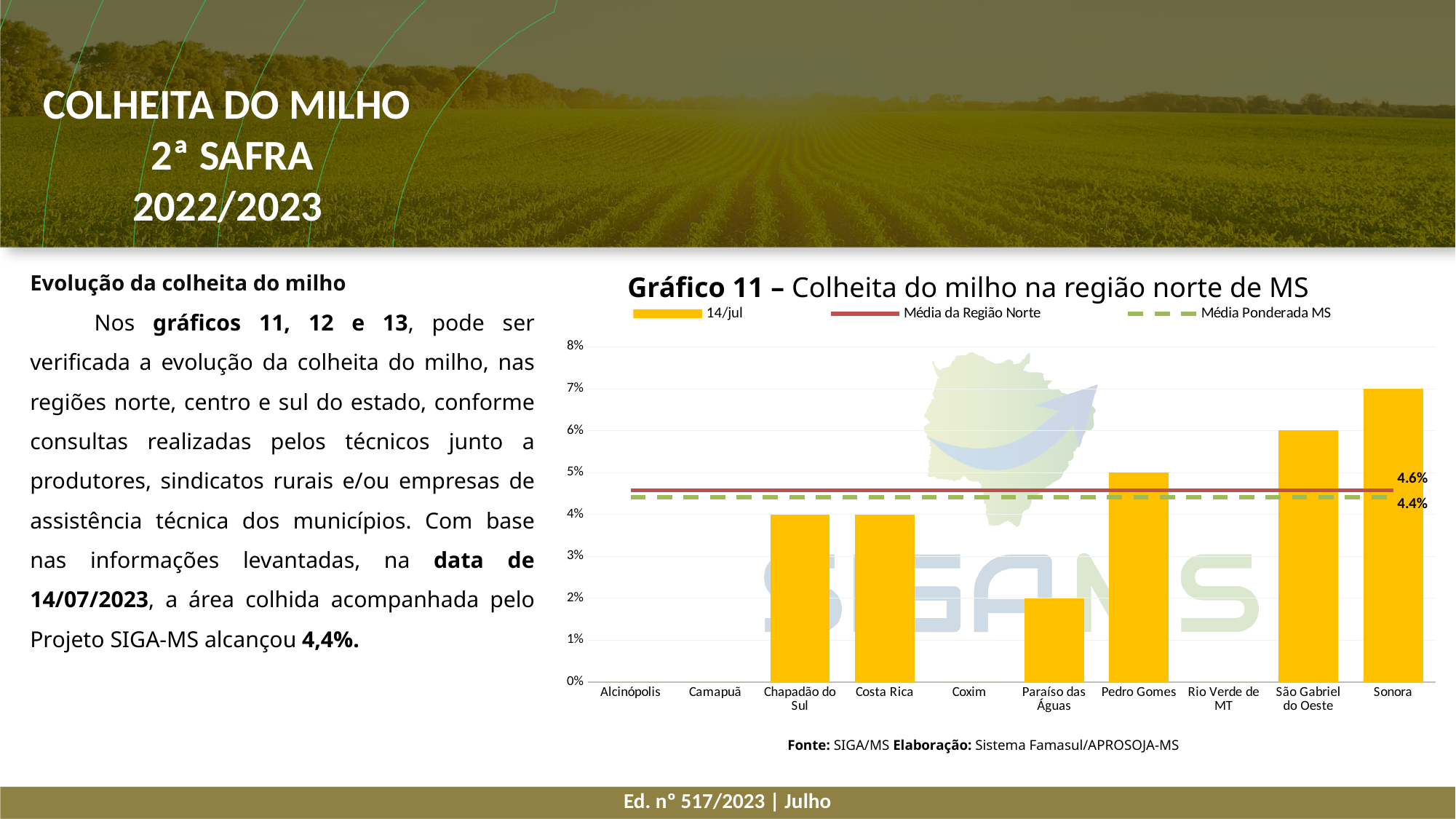
What type of chart is Gráfico 11? bar chart What value is labelled for Média da Região Norte in Gráfico 11? 4.6% What is the harvest percentage for Sonora in Gráfico 11? 7% What is the date shown in the legend for the bar series in Gráfico 11? 14/jul What is the harvest percentage for São Gabriel do Oeste in Gráfico 11? 6% Which municipality has the highest harvest percentage in Gráfico 11? Sonora How many series does the legend of Gráfico 11 list? 3 How many municipalities are shown on the x axis of Gráfico 11? 10 In Gráfico 11, which is larger: the value for Pedro Gomes or the value for Costa Rica? Pedro Gomes What value is labelled for Média Ponderada MS in Gráfico 11? 4.4% In Gráfico 11, what is the difference between Média da Região Norte and Média Ponderada MS? 0.2% In Gráfico 11, is the value for Paraíso das Águas greater or less than 3%? less